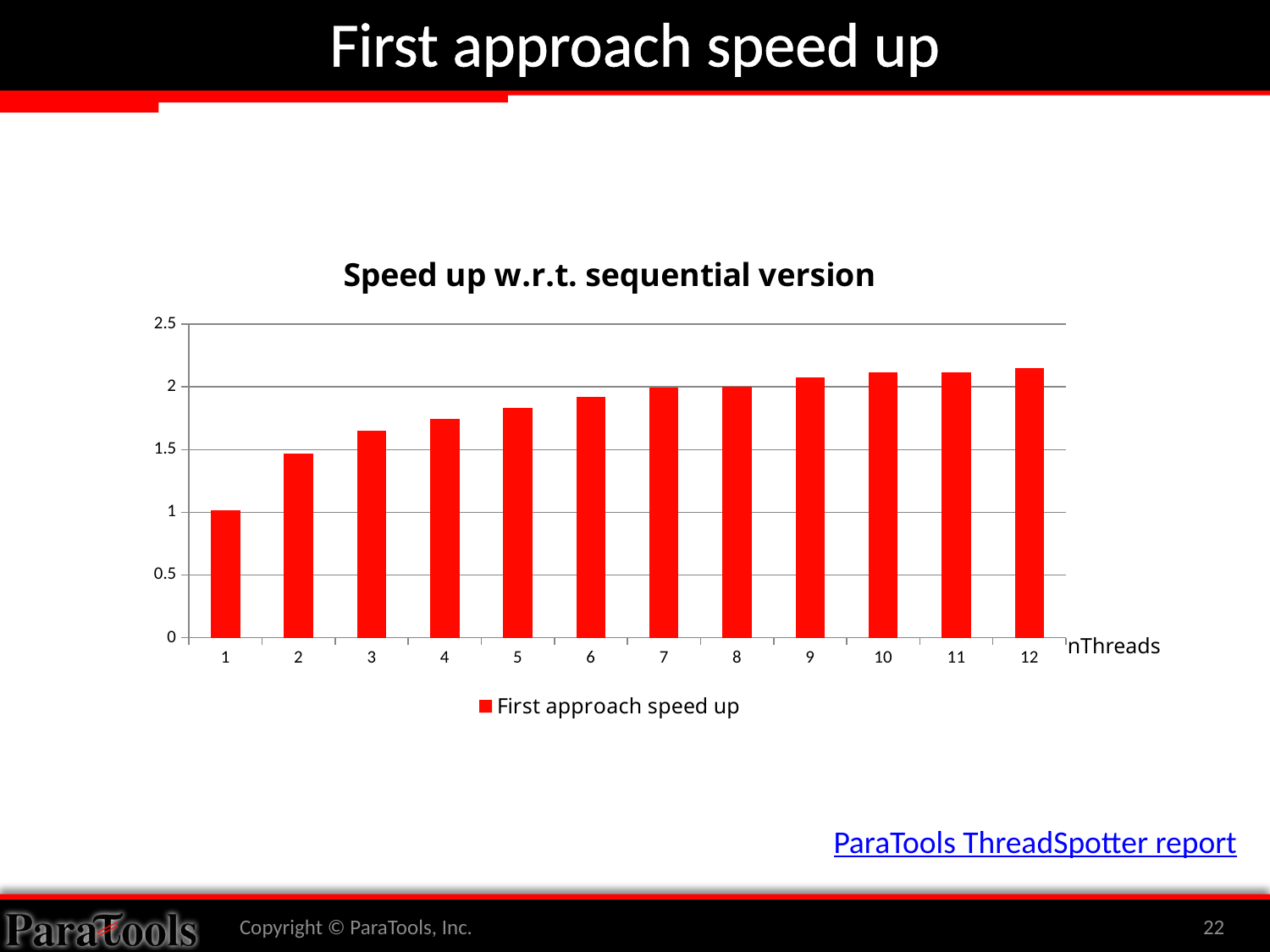
What is the name of the series shown in the legend? First approach speed up Which has the larger speed up, 3 threads or 2 threads? 3 threads Do the speed up values generally rise or fall as the number of threads increases? rise Which number of threads gives the lowest speed up? 1 How many thread counts (categories) are plotted on the x axis? 12 How many series does the legend list? 1 Is the speed up for 6 threads greater or less than 2? less Is the speed up for 3 threads greater or less than 1.5? greater Which number of threads gives the highest speed up? 12 What kind of chart is shown on the slide? bar chart What is the title of the chart? Speed up w.r.t. sequential version Is the speed up for 12 threads greater or less than 2? greater